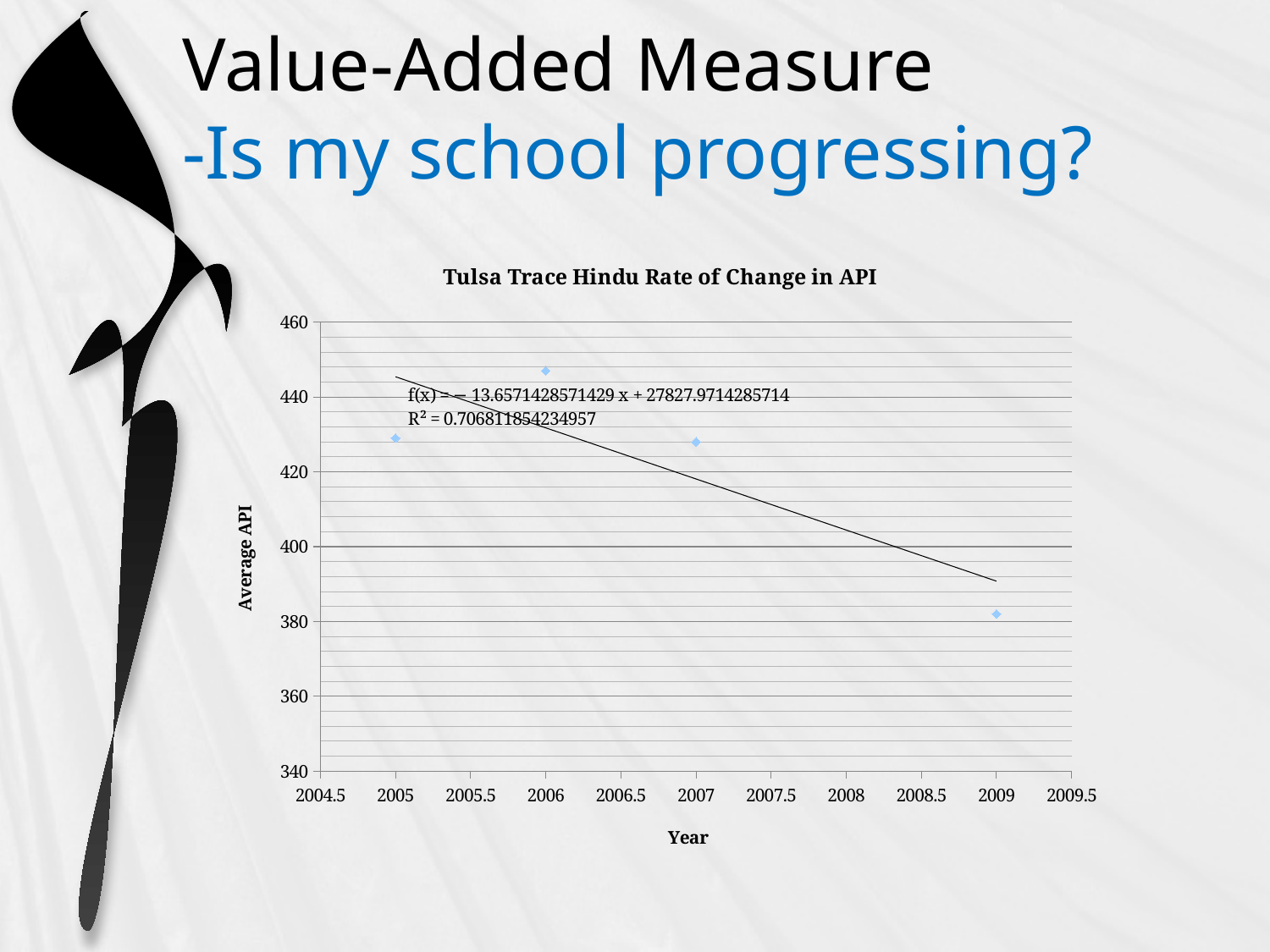
What is the title of the chart? Tulsa Trace Hindu Rate of Change in API Which year has the lowest Average API? 2009 What kind of chart is shown on the slide? Scatter chart Does the trendline on the chart rise or fall as the year increases? Fall Is the Average API for 2006 greater or less than 440? greater Which year has the highest Average API? 2006 Is the Average API for 2007 greater or less than 440? less What R² value is printed on the chart? 0.706811854234957 Which year has a higher Average API, 2007 or 2009? 2007 Is the Average API for 2005 greater or less than 420? greater How many data points are plotted on the chart? 4